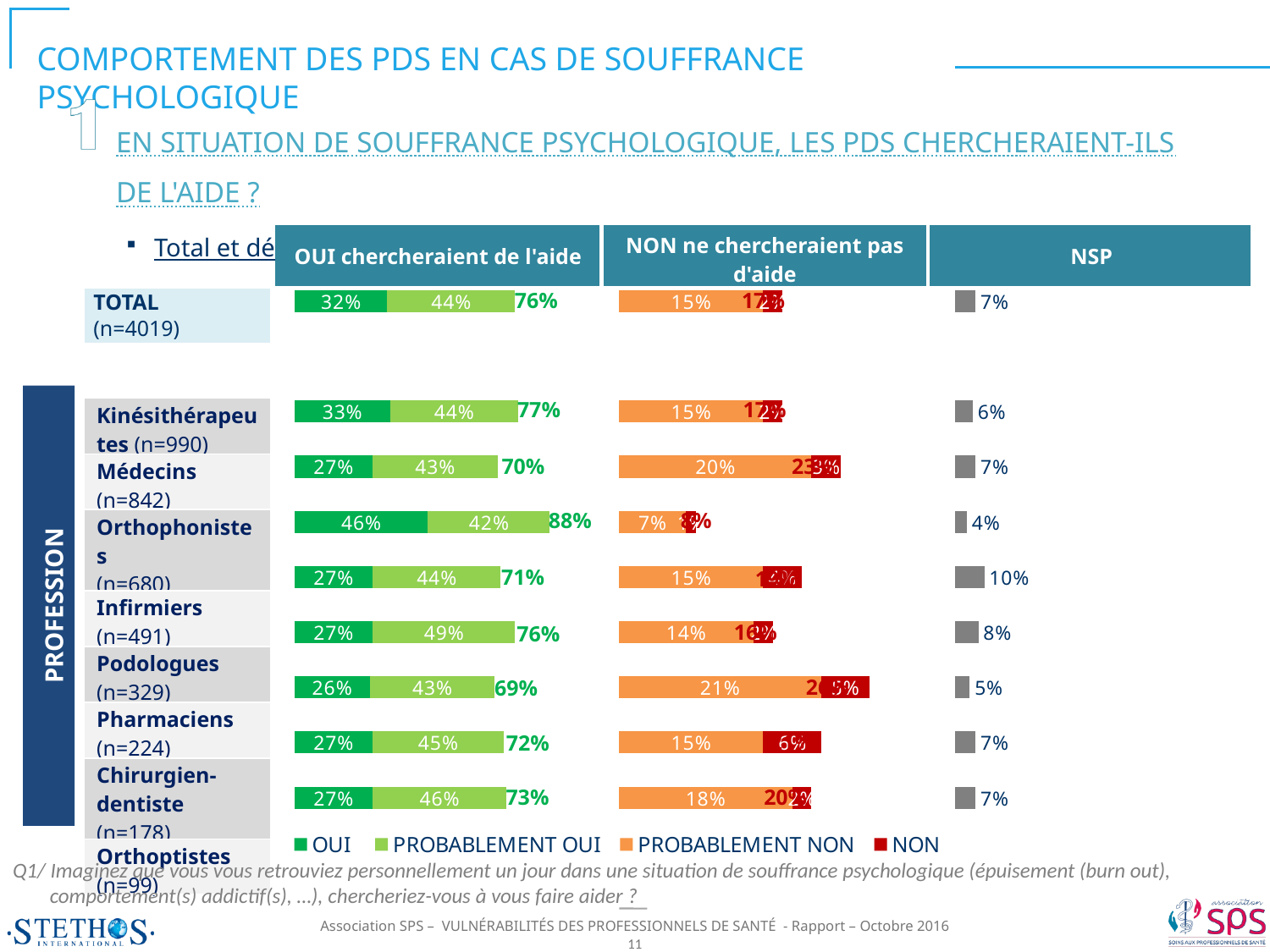
What kind of chart is used on this slide? Stacked bar chart What is the NSP value for Infirmiers? 10% What is the total 'OUI chercheraient de l'aide' percentage for the TOTAL row (n=4019)? 76% How many profession rows (excluding TOTAL) are shown in the chart? 8 How many series does the legend list? 4 Which profession has the highest total 'OUI chercheraient de l'aide' percentage? Orthophonistes What is the PROBABLEMENT NON value for Pharmaciens? 21% What is the difference between the total OUI percentage for Orthophonistes and for Pharmaciens? 19% Which is larger, the OUI value for Kinésithérapeutes or the OUI value for Médecins? Kinésithérapeutes What is the OUI value for Orthophonistes? 46% Which profession has the lowest NSP value? Orthophonistes What is the PROBABLEMENT OUI value for Podologues? 49%